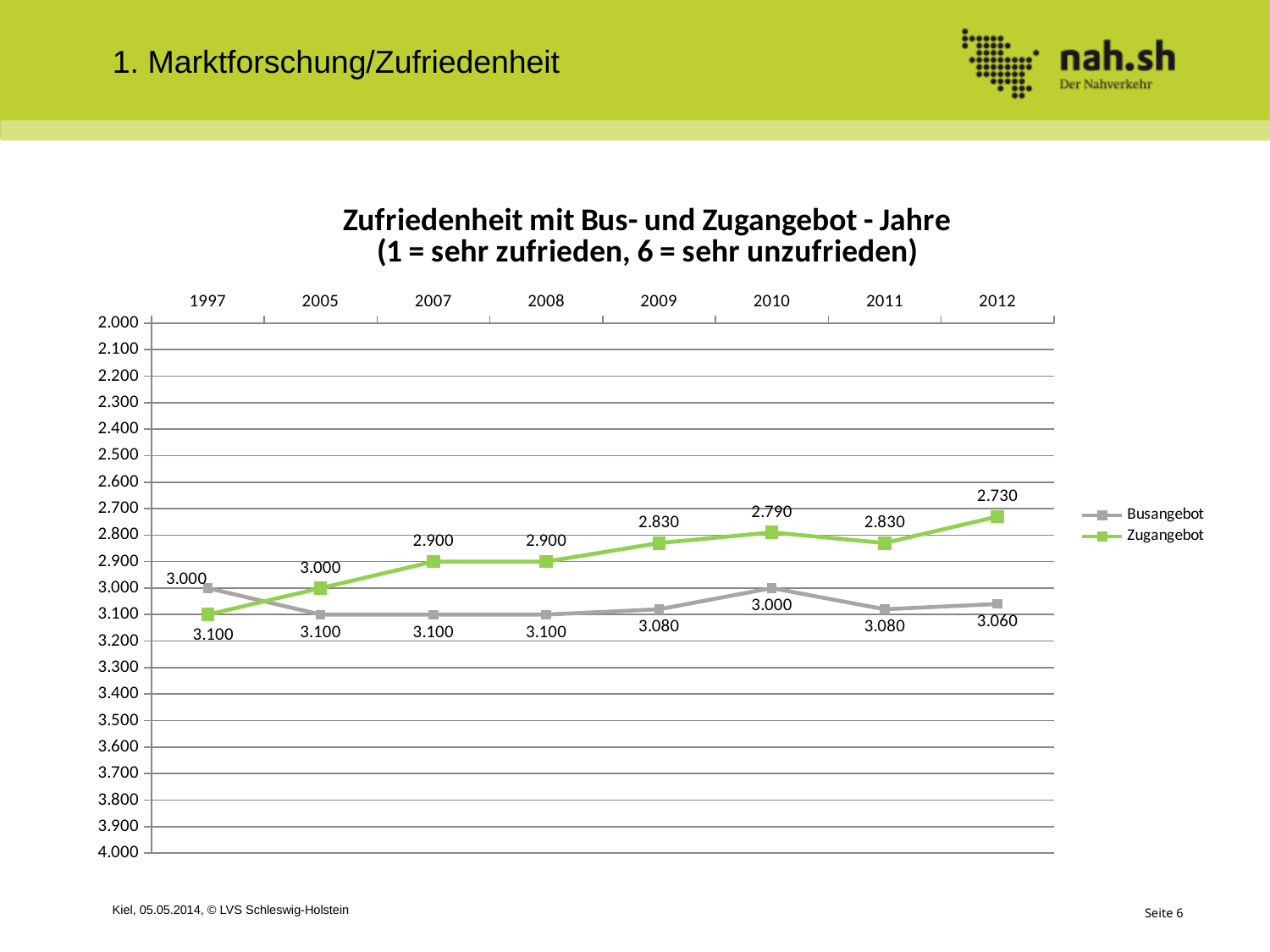
Do the Zugangebot values numerically increase or decrease from 1997 to 2012? Decrease What type of chart is shown on the slide? Line chart What is the Busangebot value for 2009? 3.080 How many series does the legend list? 2 In which year does the Zugangebot series have its highest value? 1997 What is the Zugangebot value for 2012? 2.730 In which year does the Zugangebot series have its lowest value? 2012 Which series has the numerically larger value in 2007, Busangebot or Zugangebot? Busangebot What is the Busangebot value for 2012? 3.060 How many years are shown on the x axis? 8 What is the difference between the Busangebot and Zugangebot values in 2012? 0.330 What is the Zugangebot value for 1997? 3.100